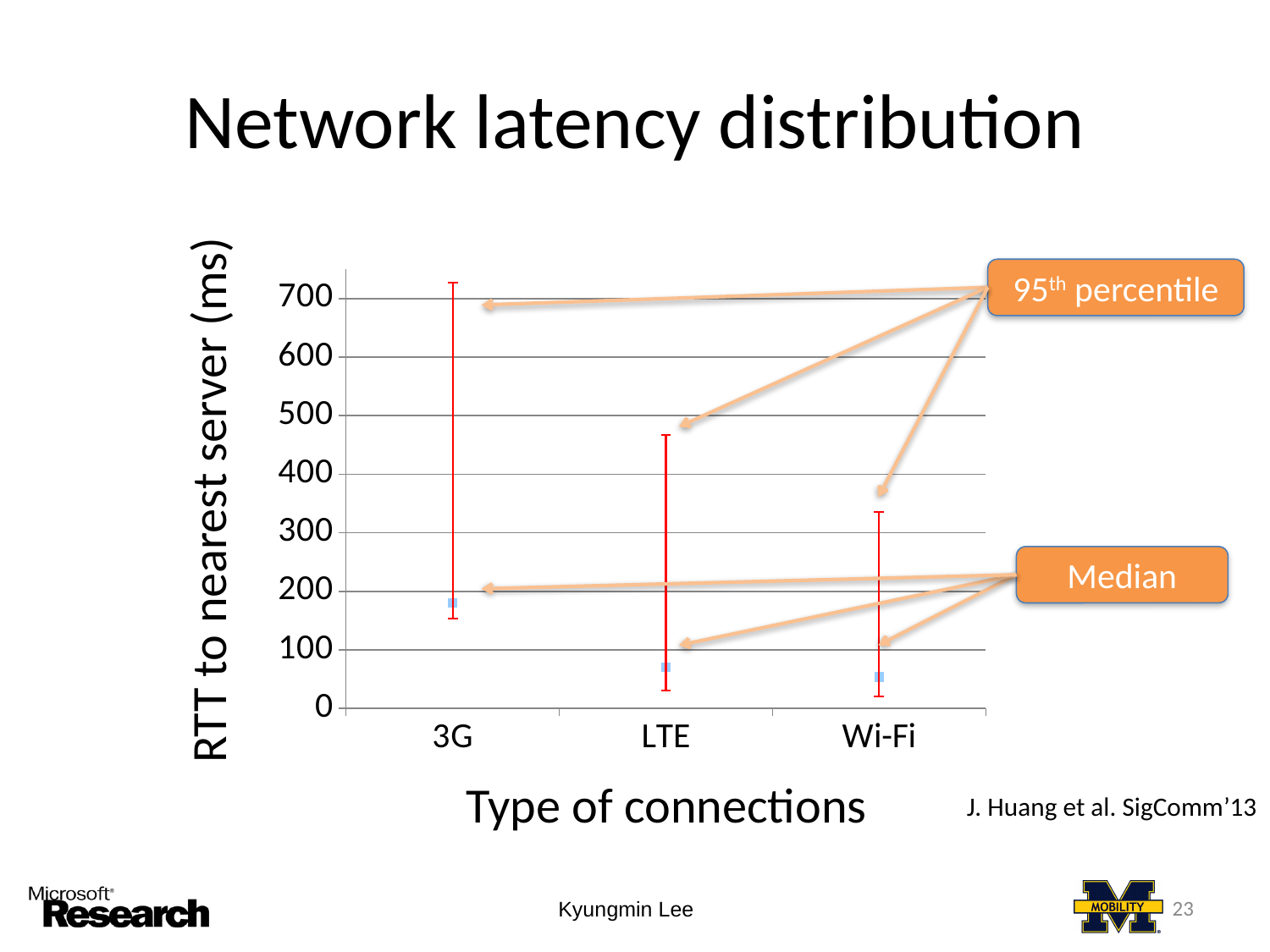
What is the label of the x axis of the chart? Type of connections How many types of connections are plotted on the x axis of the chart? 3 Is the median RTT for 3G greater or less than 100 ms? greater What is the label of the y axis of the chart? RTT to nearest server (ms) Which type of connection has the highest 95th percentile RTT? 3G Is the median RTT for LTE greater or less than 100 ms? less Is the 95th percentile RTT for 3G greater or less than 700 ms? greater Which type of connection has the lowest 95th percentile RTT? Wi-Fi Which has a larger median RTT, 3G or LTE? 3G Which type of connection has the highest median RTT? 3G